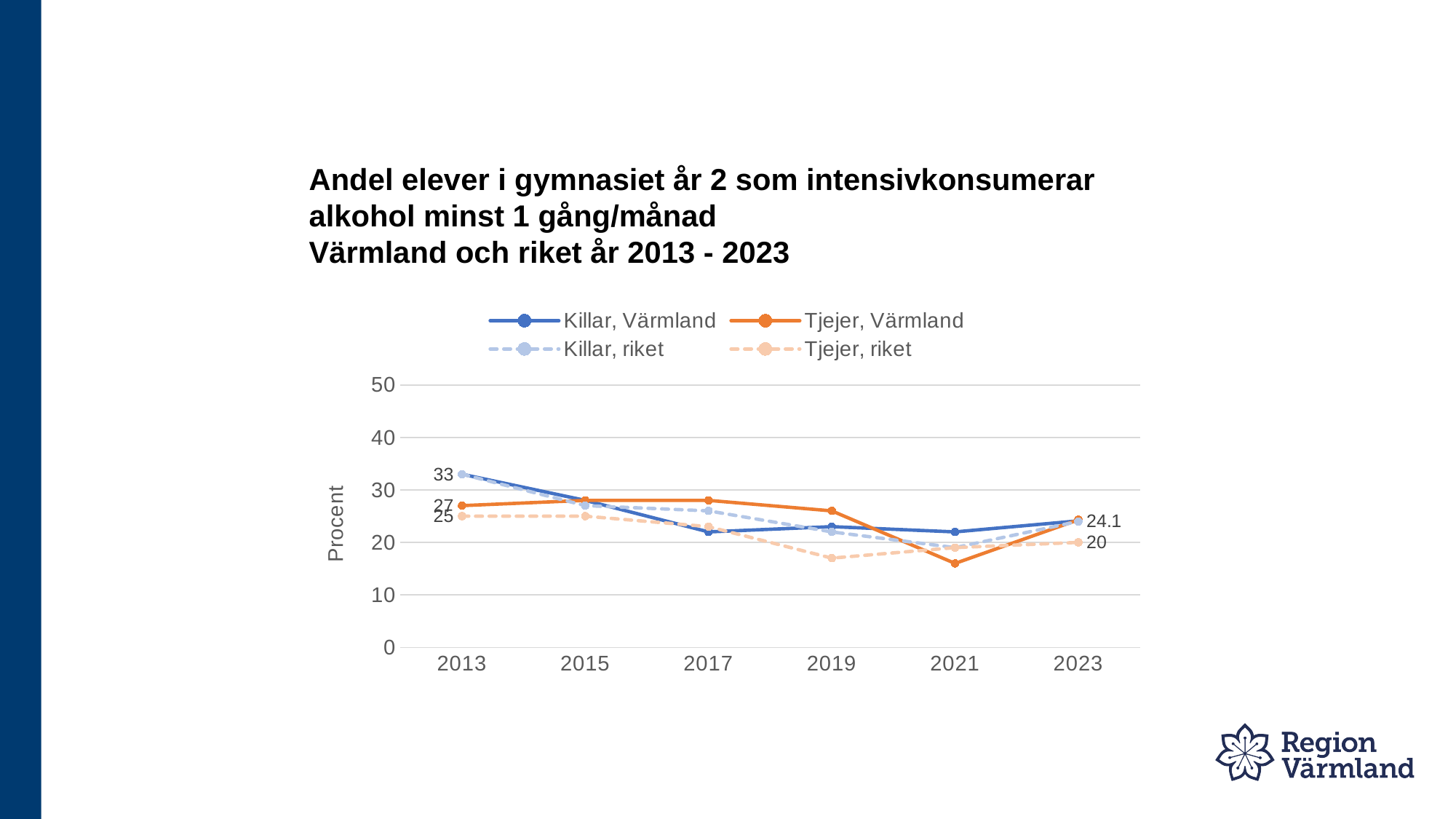
In which year does Tjejer, Värmland reach its lowest value? 2021 What is the difference between Killar, riket and Tjejer, riket in 2023? 4.1 What kind of chart is shown on the slide? line chart What is the value for Tjejer, riket in 2023? 20 How many series does the legend list? 4 How many years are shown on the x axis? 6 What is the value for Tjejer, riket in 2013? 25 What is the value for Killar, riket in 2023? 24.1 What is the label on the y axis? Procent What is the value for Killar, riket in 2013? 33 Which is larger in 2023, Killar, riket or Tjejer, riket? Killar, riket Is the value for Tjejer, Värmland in 2021 greater or less than 20? less